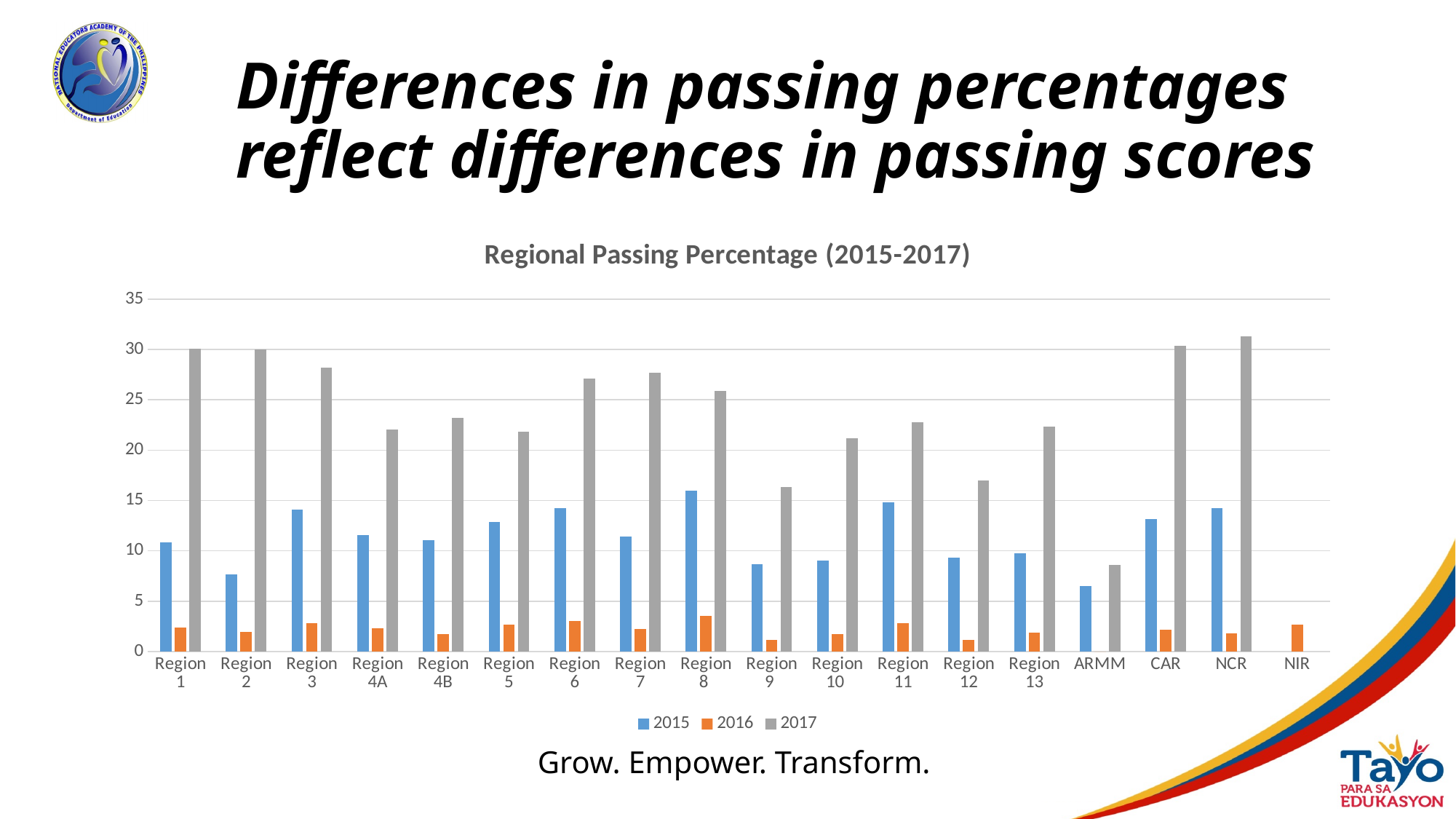
Is the 2015 value for Region 2 greater or less than 10? less What kind of chart is shown on the slide? Bar chart Which region has the highest 2016 value? Region 8 Which region has the highest 2017 value? NCR How many regions are shown on the x axis? 18 Which region has the lowest 2017 value? ARMM Is the 2017 value for Region 1 greater or less than 25? greater What is the title of the chart? Regional Passing Percentage (2015-2017) Is the 2017 value for Region 12 greater or less than 20? less How many series does the legend list? 3 Which is larger, the 2017 value for Region 1 or the 2017 value for Region 4A? Region 1 Which is larger, the 2015 value for Region 8 or the 2015 value for Region 9? Region 8